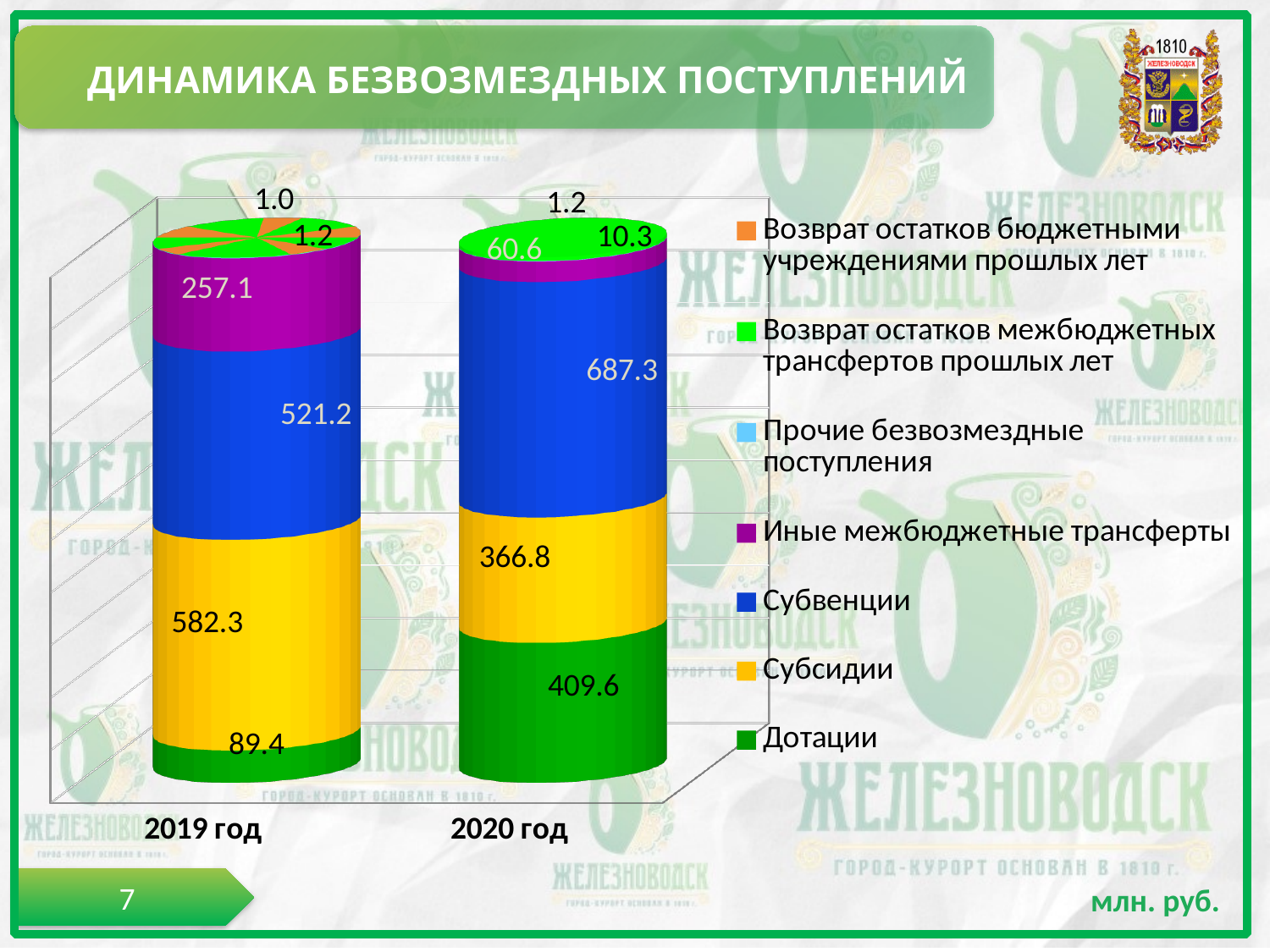
How many series does the legend list? 7 By how much did Субвенции increase from 2019 год to 2020 год? 166.1 What is the value of Иные межбюджетные трансферты for 2019 год? 257.1 Which year has the larger value for Субсидии, 2019 год or 2020 год? 2019 год Did the value of Дотации rise or fall from 2019 год to 2020 год? Rise What kind of chart is shown on the slide? Stacked bar chart What is the value of Субсидии for 2020 год? 366.8 What is the value of Дотации for 2019 год? 89.4 What is the value of Возврат остатков межбюджетных трансфертов прошлых лет for 2020 год? 10.3 How many categories (years) are plotted on the x axis? 2 In what units are the chart values given, according to the slide? млн. руб. What is the value of Субвенции for 2020 год? 687.3